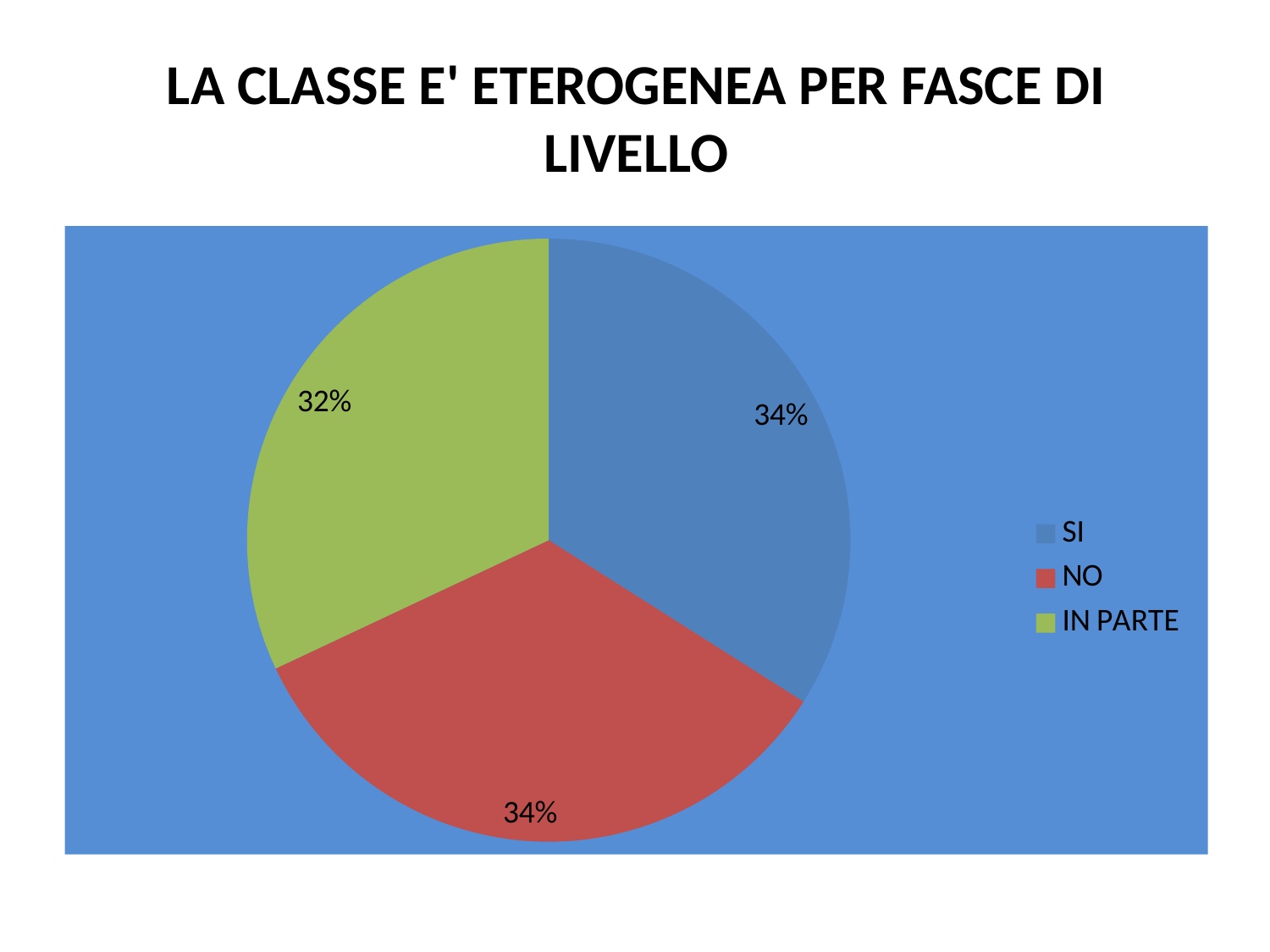
What share of the pie does the NO slice represent? 34% Which category has the smallest slice of the pie? IN PARTE How many categories does the legend list? 3 What share of the pie does the SI slice represent? 34% What is the difference in percentage points between the SI slice and the IN PARTE slice? 2% Which is larger, the NO slice or the IN PARTE slice? NO What colour is the IN PARTE slice? green What kind of chart is shown on the slide? pie chart What is the title of the chart? LA CLASSE E' ETEROGENEA PER FASCE DI LIVELLO What share of the pie does the IN PARTE slice represent? 32%